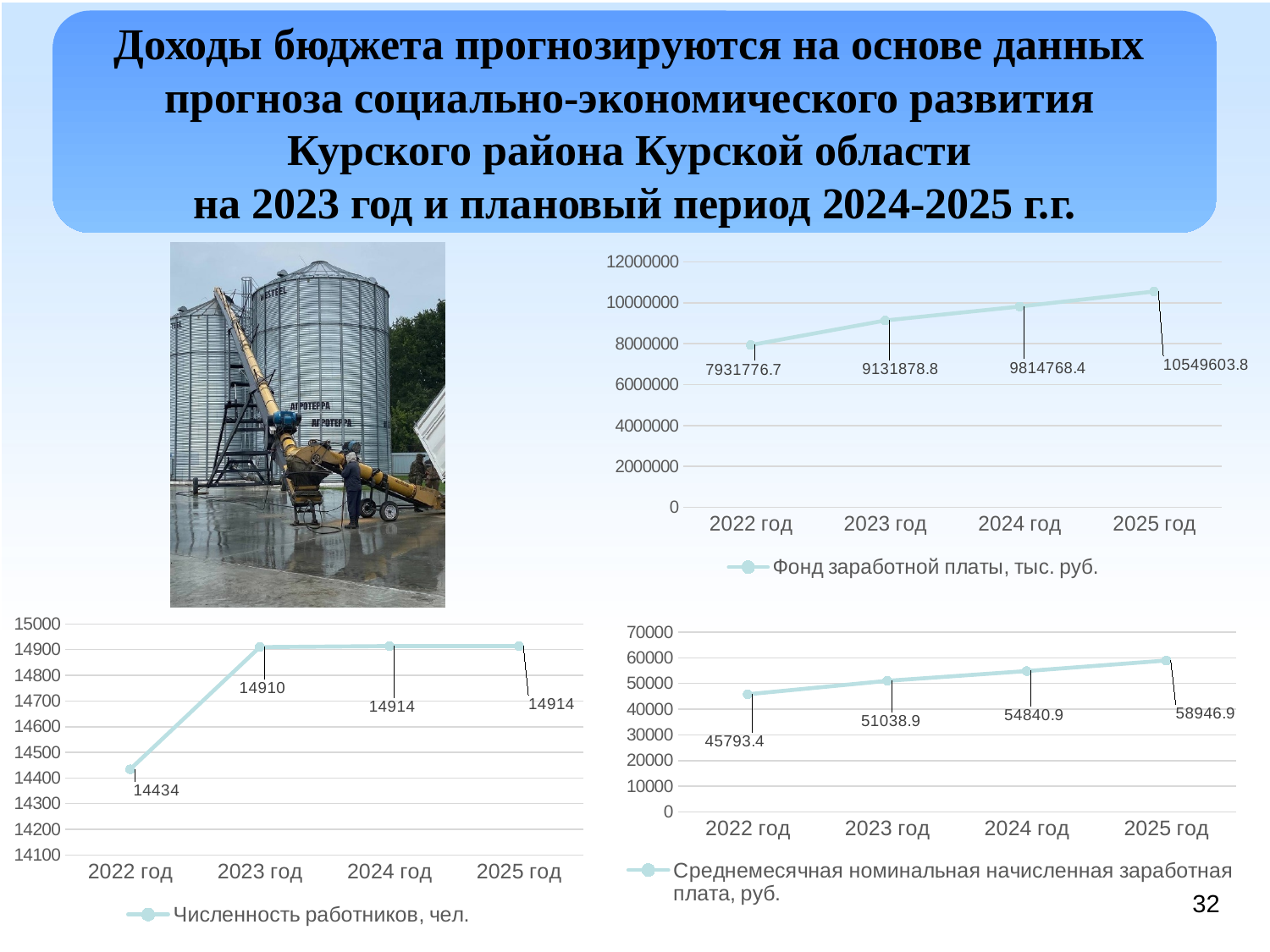
In the chart with legend 'Численность работников, чел.', what is the value for 2022 год? 14434 In the chart with legend 'Численность работников, чел.', what is the difference between the 2023 год and 2022 год values? 476 In the chart with legend 'Фонд заработной платы, тыс. руб.', do the values rise or fall from 2022 год to 2025 год? rise What type of chart is the one with legend 'Среднемесячная номинальная начисленная заработная плата, руб.'? line chart In the chart with legend 'Фонд заработной платы, тыс. руб.', what is the value for 2023 год? 9131878.8 In the chart with legend 'Среднемесячная номинальная начисленная заработная плата, руб.', what is the value for 2024 год? 54840.9 In the chart with legend 'Среднемесячная номинальная начисленная заработная плата, руб.', is the value for 2022 год greater or less than 40000? greater In the chart with legend 'Среднемесячная номинальная начисленная заработная плата, руб.', which is larger, the value for 2023 год or 2025 год? 2025 год In the chart with legend 'Фонд заработной платы, тыс. руб.', what is the difference between the 2025 год and 2022 год values? 2617827.1 In the chart with legend 'Численность работников, чел.', how many years are plotted? 4 In the chart with legend 'Численность работников, чел.', which year has the lowest value? 2022 год In the chart with legend 'Фонд заработной платы, тыс. руб.', which year has the highest value? 2025 год